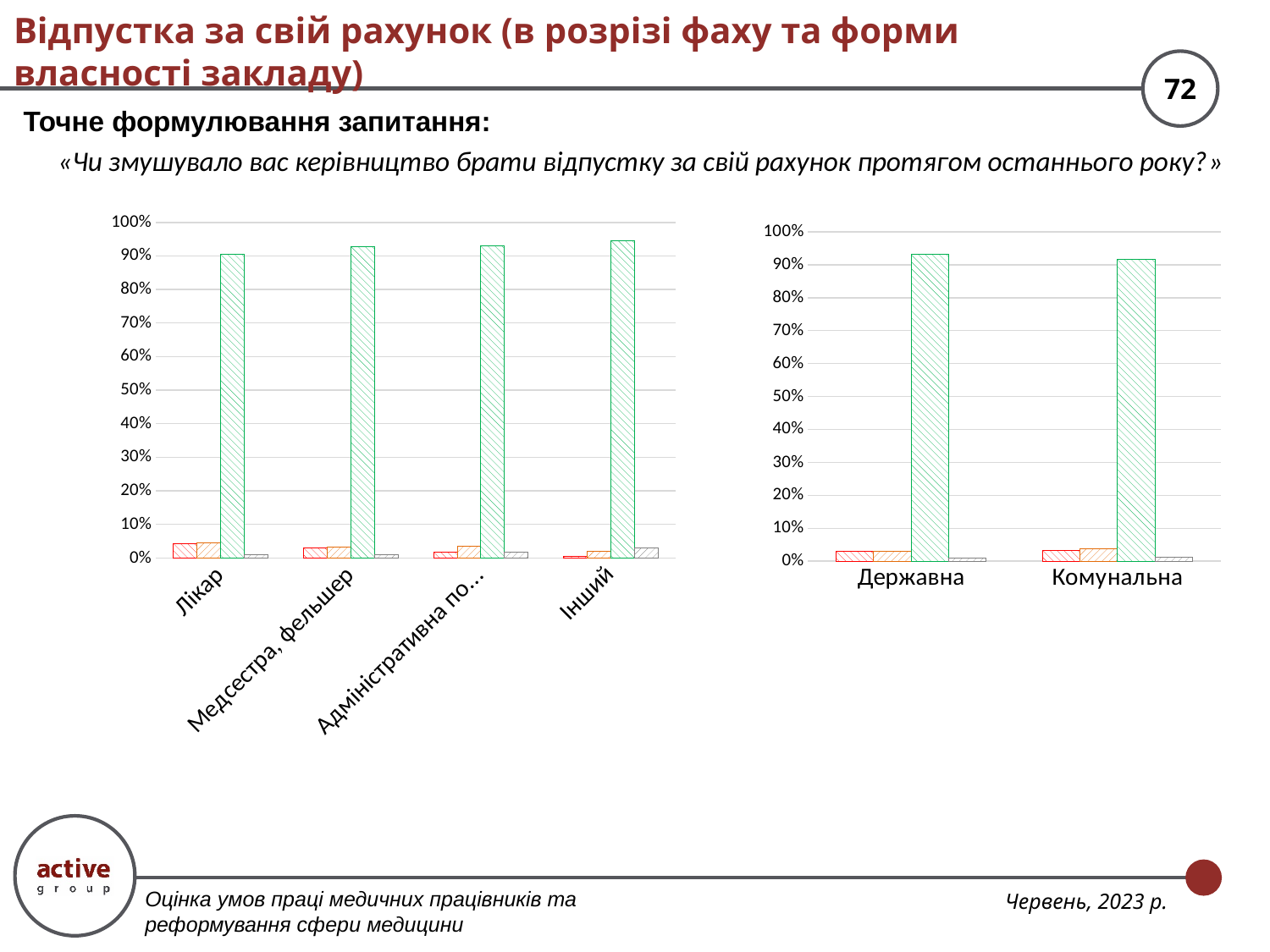
In the right chart (by form of ownership), is the tallest (green hatched) bar for Комунальна greater or less than 50%? greater How many bars are plotted for each category in the right chart (by form of ownership)? 4 In the left chart (by profession), is the tallest (green hatched) bar for Лікар greater or less than 80%? greater How many categories are shown on the x axis of the left chart (by profession)? 4 What kind of chart is the left chart (by profession)? bar chart In the left chart (by profession), which category has the lowest green hatched bar? Лікар How many charts are shown on the slide? 2 In the right chart (by form of ownership), is the tallest (green hatched) bar for Державна greater or less than 80%? greater How many categories are shown on the x axis of the right chart (by form of ownership)? 2 In the left chart (by profession), which is larger for Лікар: the green hatched bar or the red hatched bar? the green hatched bar